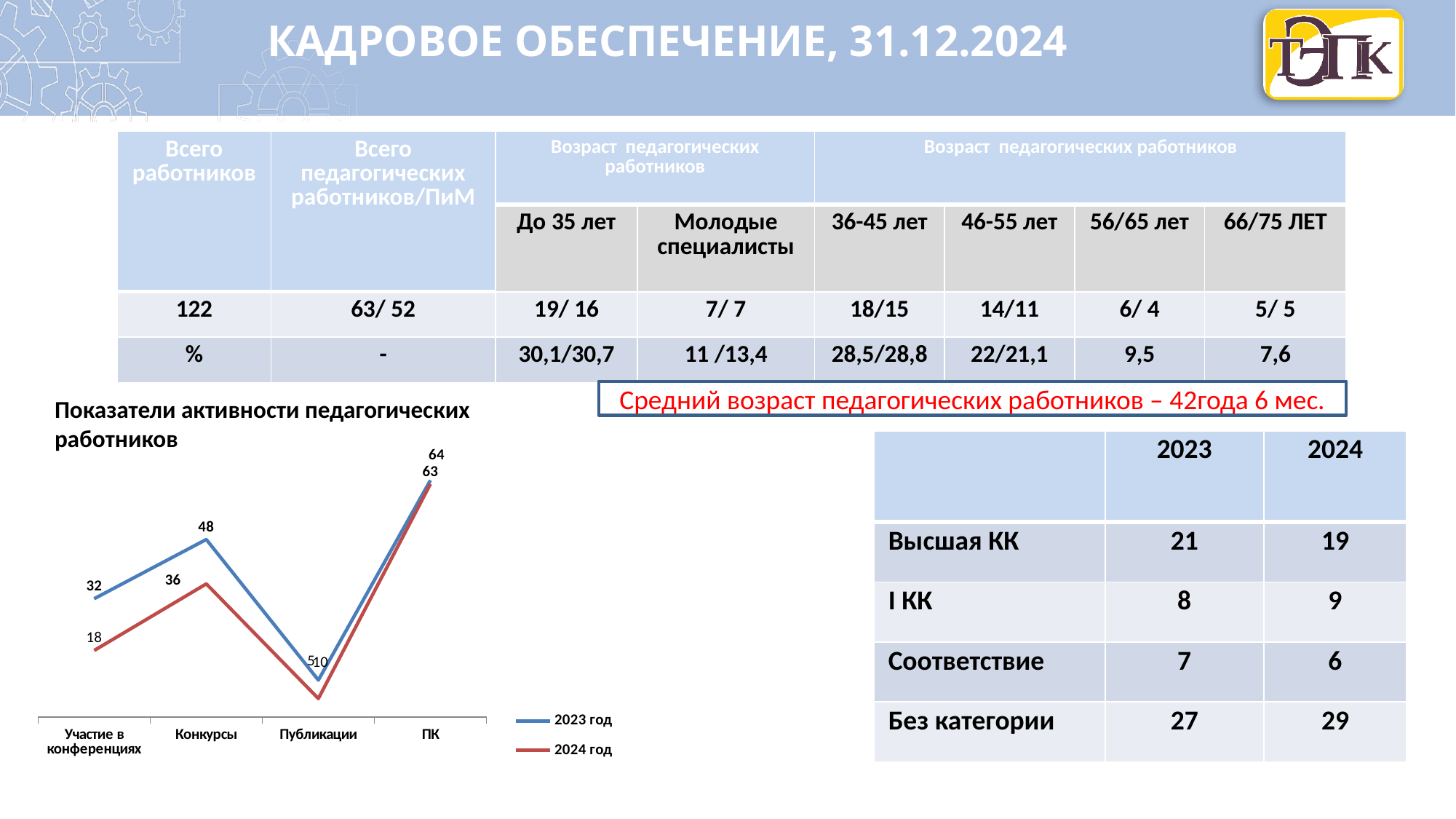
What is the value for 2024 год for Участие в конференциях? 18 What is the difference between the 2023 год and 2024 год values for Участие в конференциях? 14 How many series does the chart legend list? 2 What is the value for 2024 год for Конкурсы? 36 What type of chart is shown on the slide? line chart How many categories are shown on the x axis of the chart? 4 Which series has the larger value for Конкурсы, 2023 год or 2024 год? 2023 год Which category has the highest value for the 2023 год series? ПК Do the values for the 2024 год series rise or fall from Конкурсы to Публикации? fall What is the value for 2023 год for Конкурсы? 48 What is the value for 2023 год for Участие в конференциях? 32 Which category has the lowest value for the 2024 год series? Публикации